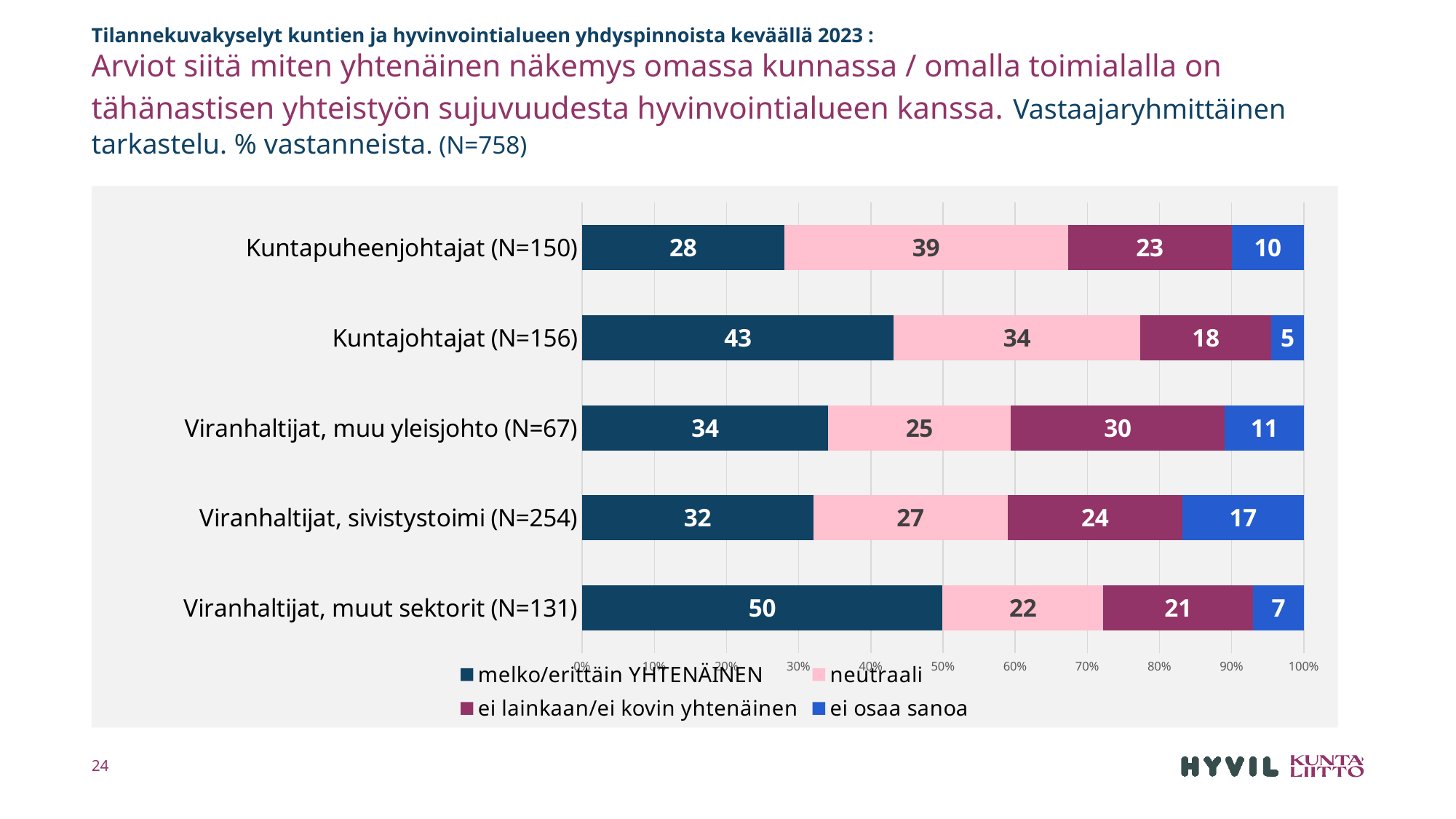
What kind of chart is shown on the slide? Stacked bar chart What is the difference between the 'melko/erittäin YHTENÄINEN' values for Viranhaltijat, muut sektorit (N=131) and Kuntapuheenjohtajat (N=150)? 22 What is the value for 'melko/erittäin YHTENÄINEN' for Kuntajohtajat (N=156)? 43 What is the value for 'ei lainkaan/ei kovin yhtenäinen' for Viranhaltijat, muu yleisjohto (N=67)? 30 Which respondent group has the lowest value for 'ei osaa sanoa'? Kuntajohtajat (N=156) How many respondent groups are shown in the chart? 5 How many series does the legend list? 4 What is the value for 'neutraali' for Kuntapuheenjohtajat (N=150)? 39 Which is larger: the 'neutraali' value for Kuntajohtajat (N=156) or for Viranhaltijat, sivistystoimi (N=254)? Kuntajohtajat (N=156) What is the total of the stacked bar for Viranhaltijat, muut sektorit (N=131)? 100 What is the value for 'ei osaa sanoa' for Viranhaltijat, sivistystoimi (N=254)? 17 Which respondent group has the highest value for 'melko/erittäin YHTENÄINEN'? Viranhaltijat, muut sektorit (N=131)